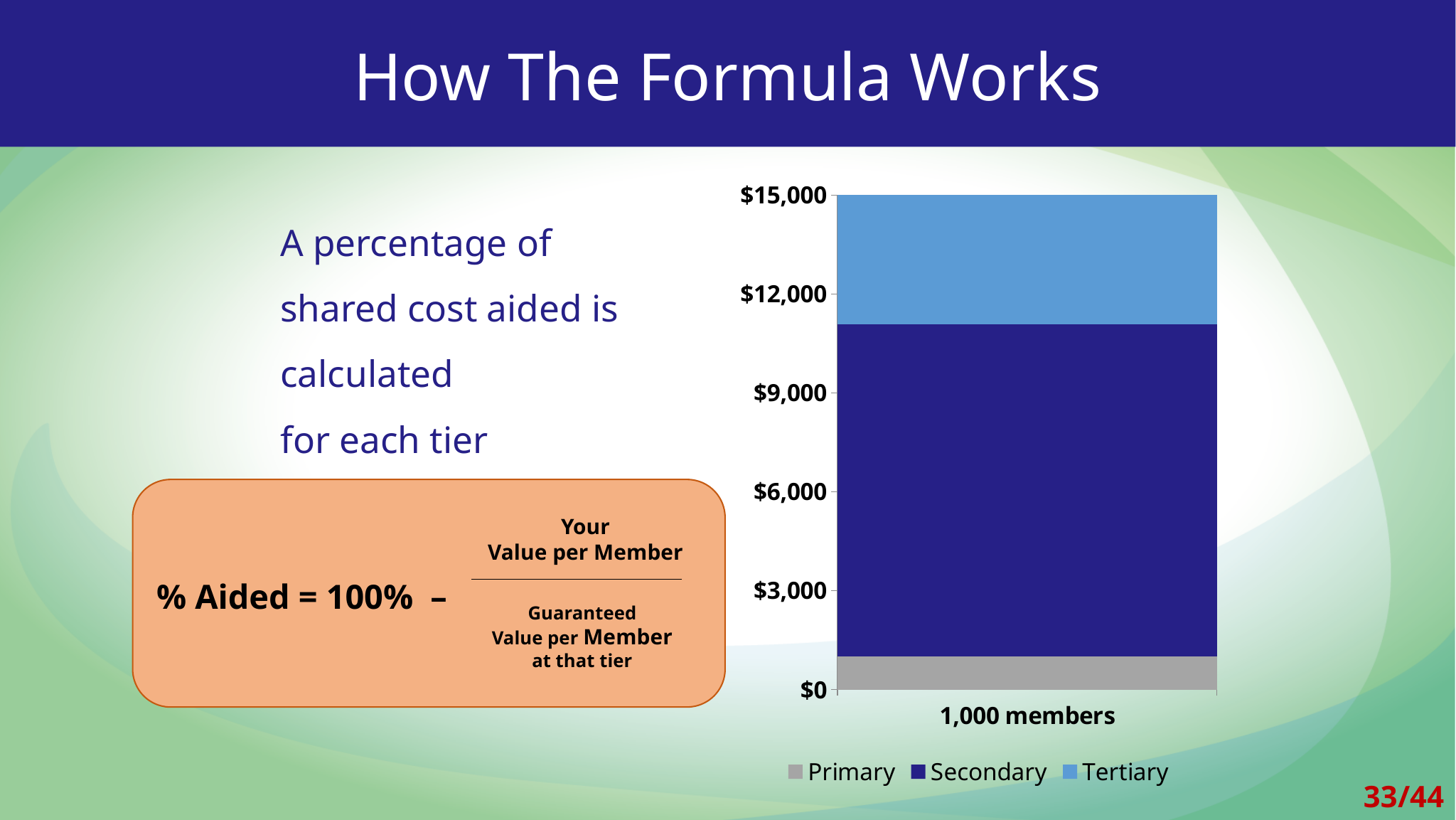
Is the Tertiary segment of the bar greater or less than $6,000? less What is the total value of the stacked bar for 1,000 members? $15,000 What is the label of the single category on the x axis? 1,000 members Is the Secondary segment of the bar greater or less than $6,000? greater How many series does the chart legend list? 3 Is the Primary segment of the bar greater or less than $3,000? less What is the highest value shown on the y axis of the chart? $15,000 Which series makes up the smallest segment of the stacked bar? Primary Which series makes up the largest segment of the stacked bar? Secondary How many categories are shown on the x axis of the chart? 1 What kind of chart is shown on the slide? Stacked bar chart Which segment is larger, Tertiary or Primary? Tertiary